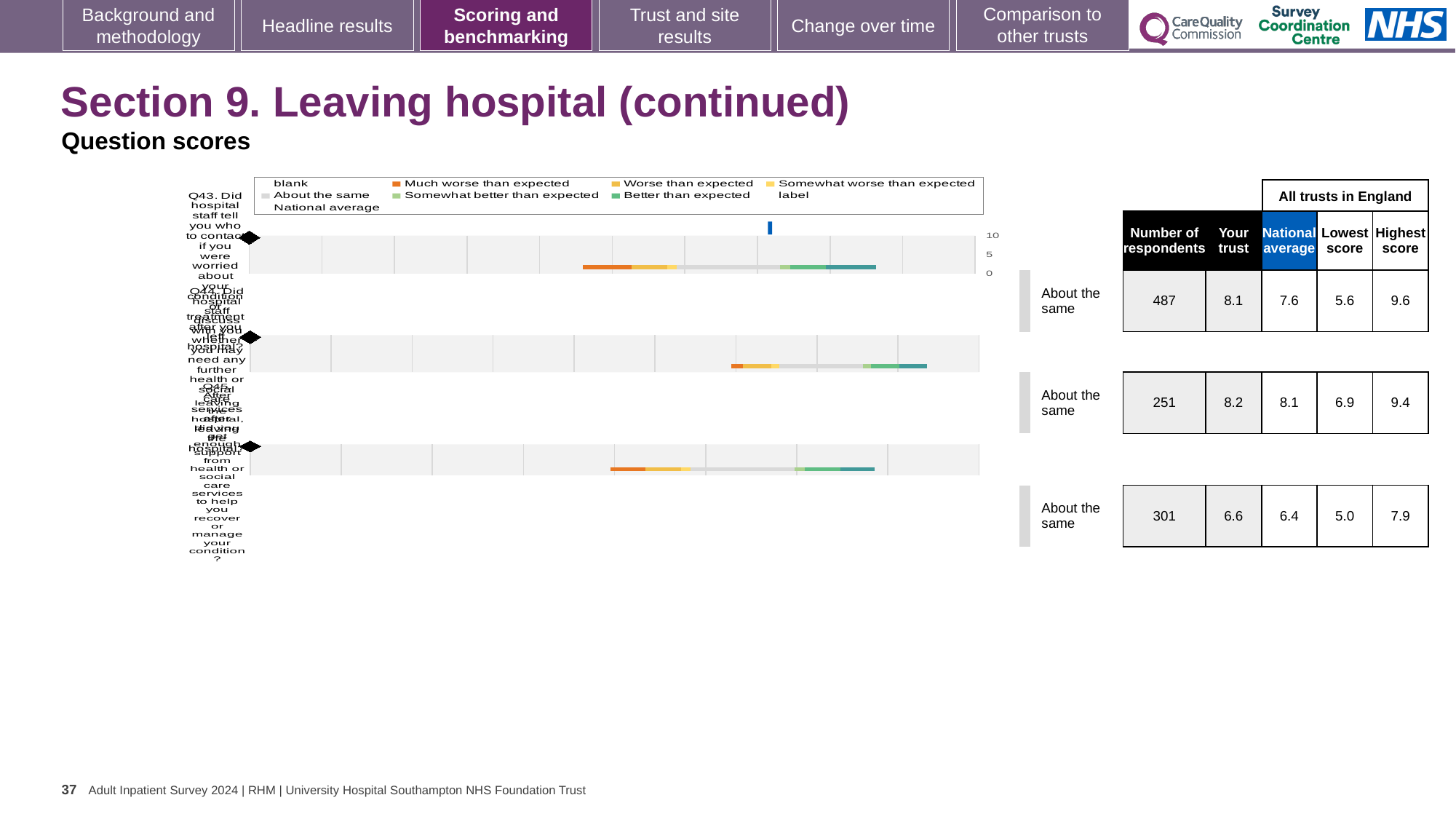
For the top chart (Q43), which is larger: the 'Your trust' score or the national average? Your trust For the top chart (Q43), what is the national average score? 7.6 Which of the three charts has the highest 'Your trust' score? The second chart (8.2) For the third (bottom) chart, what is the difference between the 'Your trust' score and the national average? 0.2 What is the maximum value shown on the score axis of the charts? 10 For the third (bottom) chart, what is the highest score among all trusts in England? 7.9 What kind of chart is used to show the question scores on this slide? Bar chart For the second chart, how many respondents are listed? 251 What benchmark category is shown next to each of the three charts? About the same Which of the three charts has the lowest number of respondents? The second chart (251) How many question charts are shown on the slide? 3 For the top chart (Q43), what is the 'Your trust' score shown in the table? 8.1